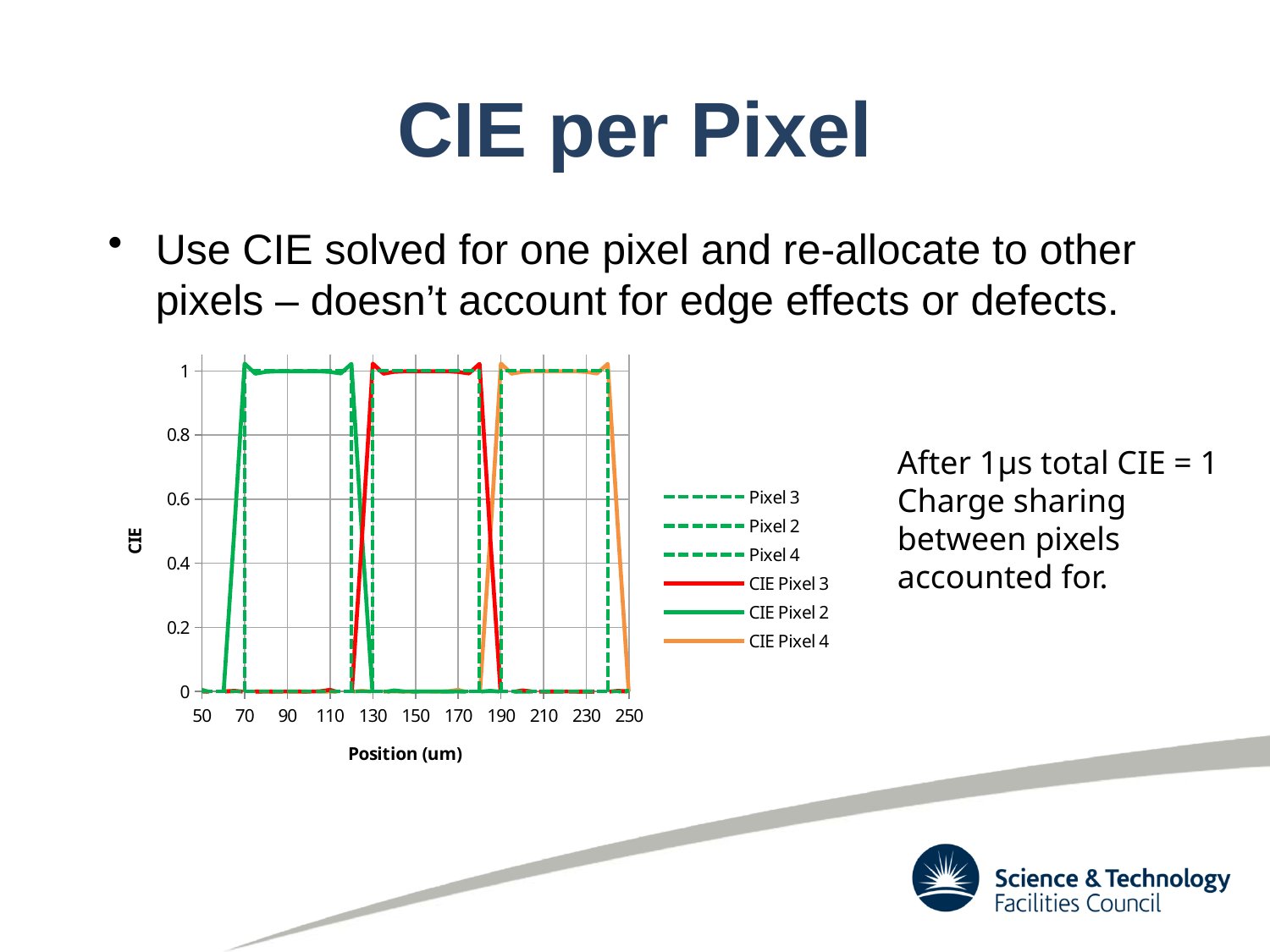
Is the value of CIE Pixel 2 at position 150 greater or less than 0.2? less Is the value of CIE Pixel 3 at position 90 greater or less than 0.2? less Is the value of CIE Pixel 3 at position 150 greater or less than 0.8? greater At position 150, which series has the larger value: CIE Pixel 3 or CIE Pixel 2? CIE Pixel 3 How many series does the chart legend list? 6 What is the title of the x axis of the chart? Position (um) At position 210, which series has the larger value: CIE Pixel 4 or CIE Pixel 3? CIE Pixel 4 What kind of chart is shown on the slide? line chart What colour is the CIE Pixel 3 line in the chart? red